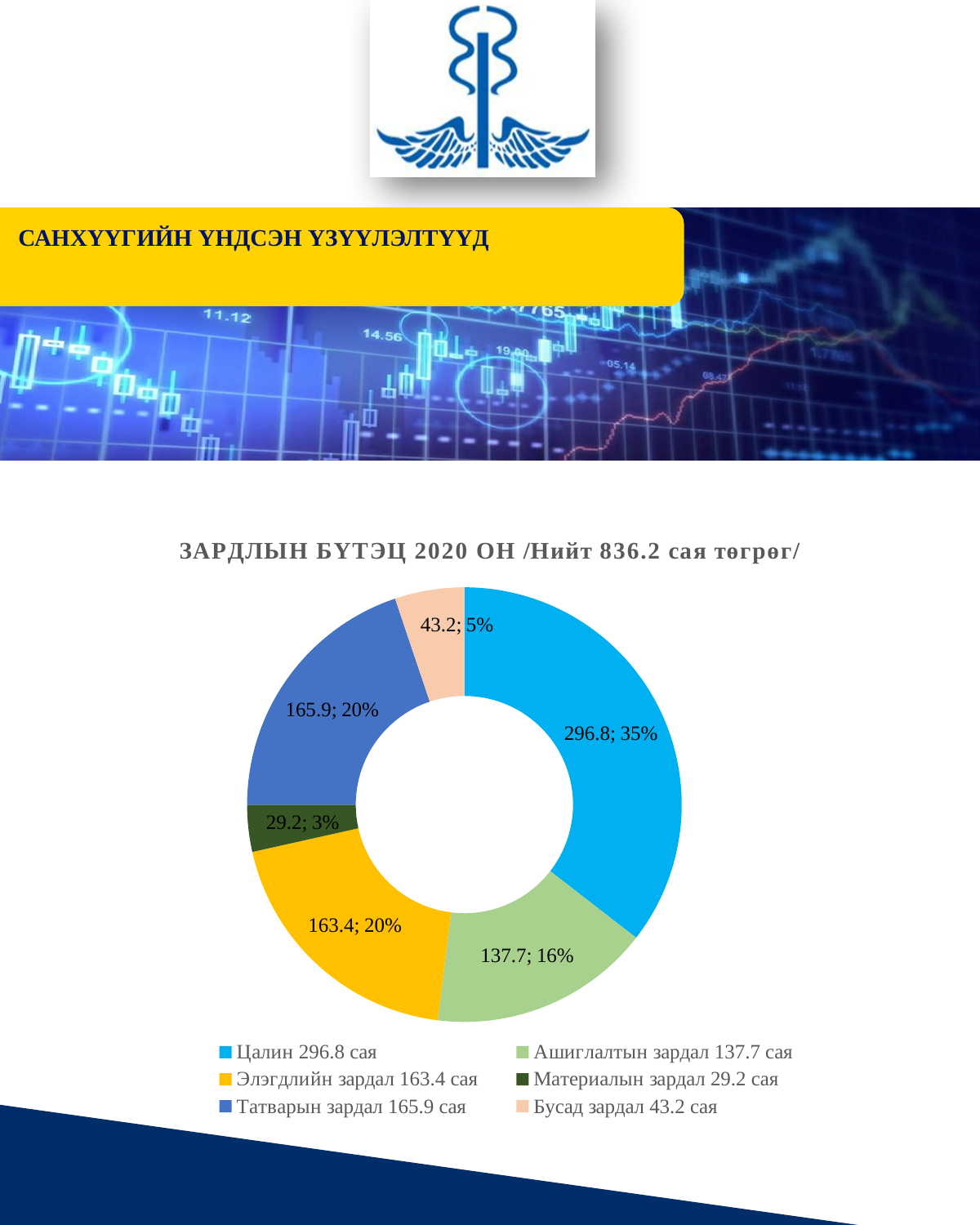
Which category has the largest value? Цалин How many categories does the chart show? 6 Which category has the smallest value? Материалын зардал What is the difference between the values for Цалин and Ашиглалтын зардал? 159.1 What is the value for Цалин? 296.8 What share of the total does Татварын зардал represent? 20% What kind of chart is shown on the slide? Pie (doughnut) chart Which is larger, the value for Элэгдлийн зардал or the value for Бусад зардал? Элэгдлийн зардал What is the value for Ашиглалтын зардал? 137.7 What share of the total does Бусад зардал represent? 5% What is the title of the chart? ЗАРДЛЫН БҮТЭЦ 2020 ОН /Нийт 836.2 сая төгрөг/ What is the value for Материалын зардал? 29.2